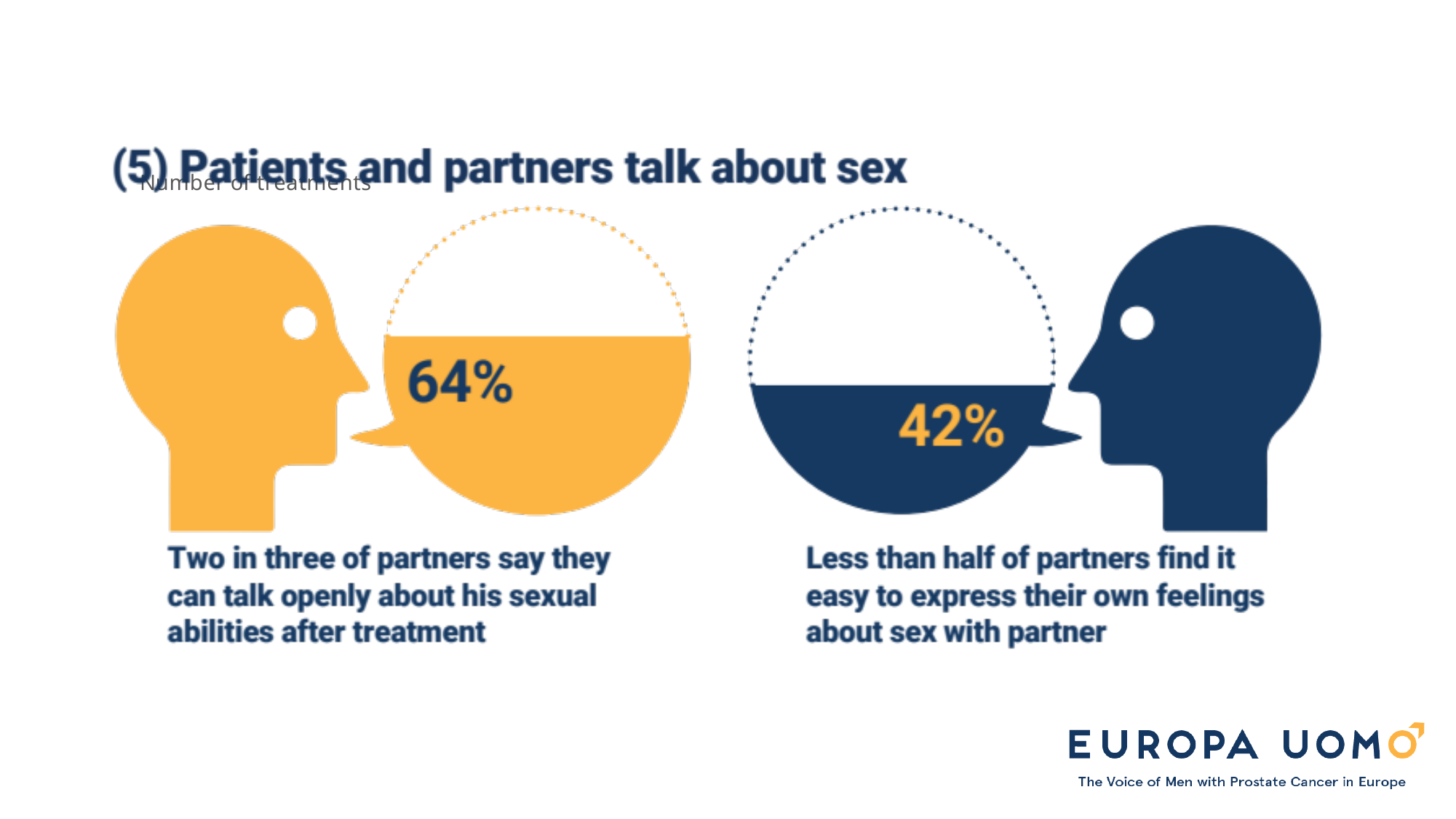
Which of the two percentages on the slide is higher, the left circle or the right circle? the left circle (64%) What percentage of partners find it easy to express their own feelings about sex with their partner? 42% What percentage is shown in the left (orange) circle? 64% What is the difference in percentage points between the left circle value and the right circle value? 22 percentage points What percentage of partners say they can talk openly about his sexual abilities after treatment? 64% What is the title of the slide? (5) Patients and partners talk about sex How many percentage statistics are displayed on the slide? 2 Is the value in the left circle greater or less than 50%? greater Which statistic on the slide is the lowest? 42% (partners who find it easy to express their own feelings about sex) What colour is the circle showing 42%? dark blue What percentage is shown in the right (dark blue) circle? 42% Is the value in the right circle greater or less than 50%? less